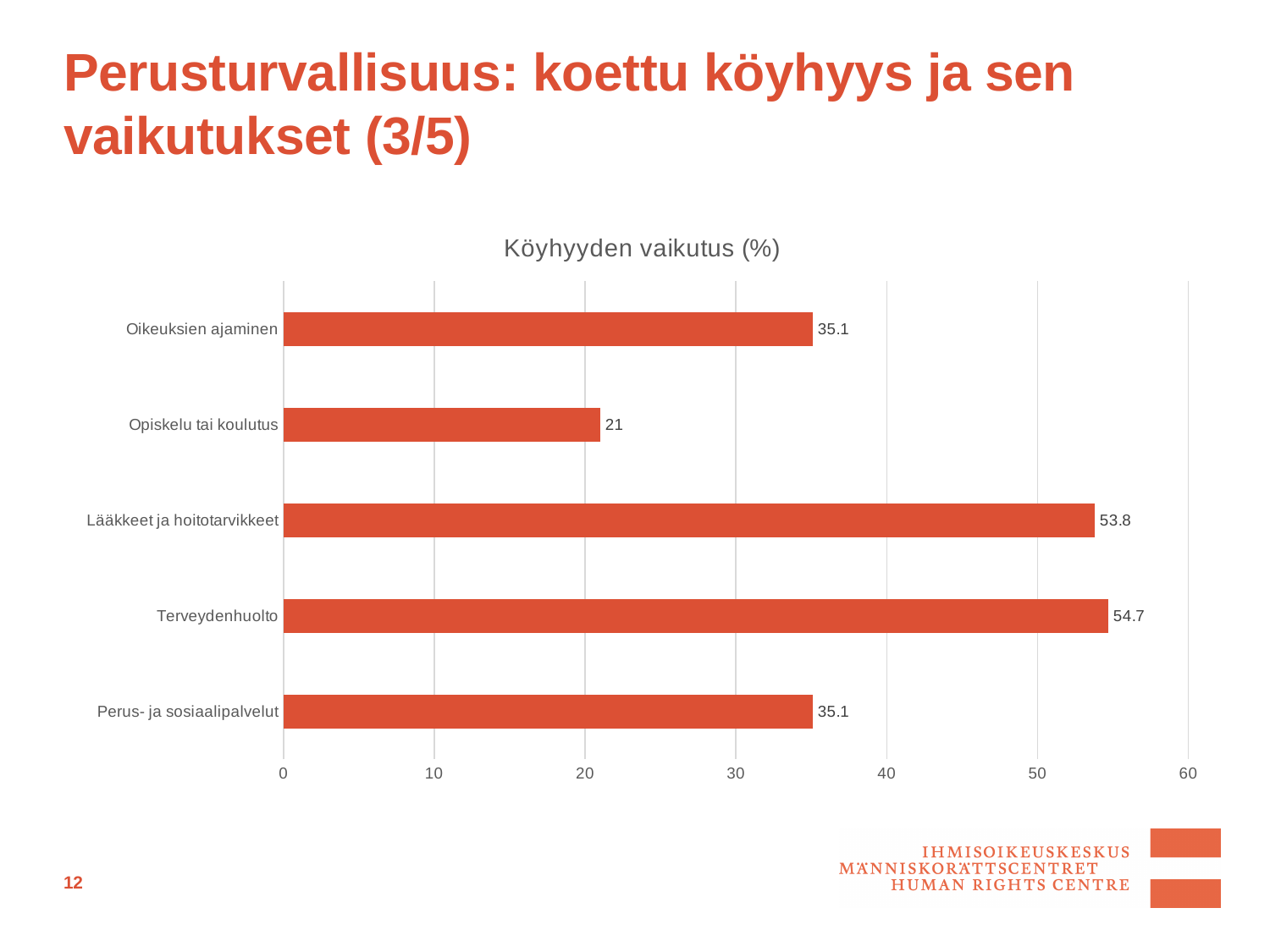
What is the value for Opiskelu tai koulutus? 21 Which is larger, the value for Lääkkeet ja hoitotarvikkeet or the value for Perus- ja sosiaalipalvelut? Lääkkeet ja hoitotarvikkeet What is the value for Oikeuksien ajaminen? 35.1 What is the difference between the values for Oikeuksien ajaminen and Opiskelu tai koulutus? 14.1 How many categories are shown in the chart? 5 What kind of chart is shown on the slide? Bar chart Which category has the highest value? Terveydenhuolto Which category has the lowest value? Opiskelu tai koulutus What is the value for Lääkkeet ja hoitotarvikkeet? 53.8 What is the difference between the values for Terveydenhuolto and Lääkkeet ja hoitotarvikkeet? 0.9 What is the value for Terveydenhuolto? 54.7 What is the title of the chart? Köyhyyden vaikutus (%)